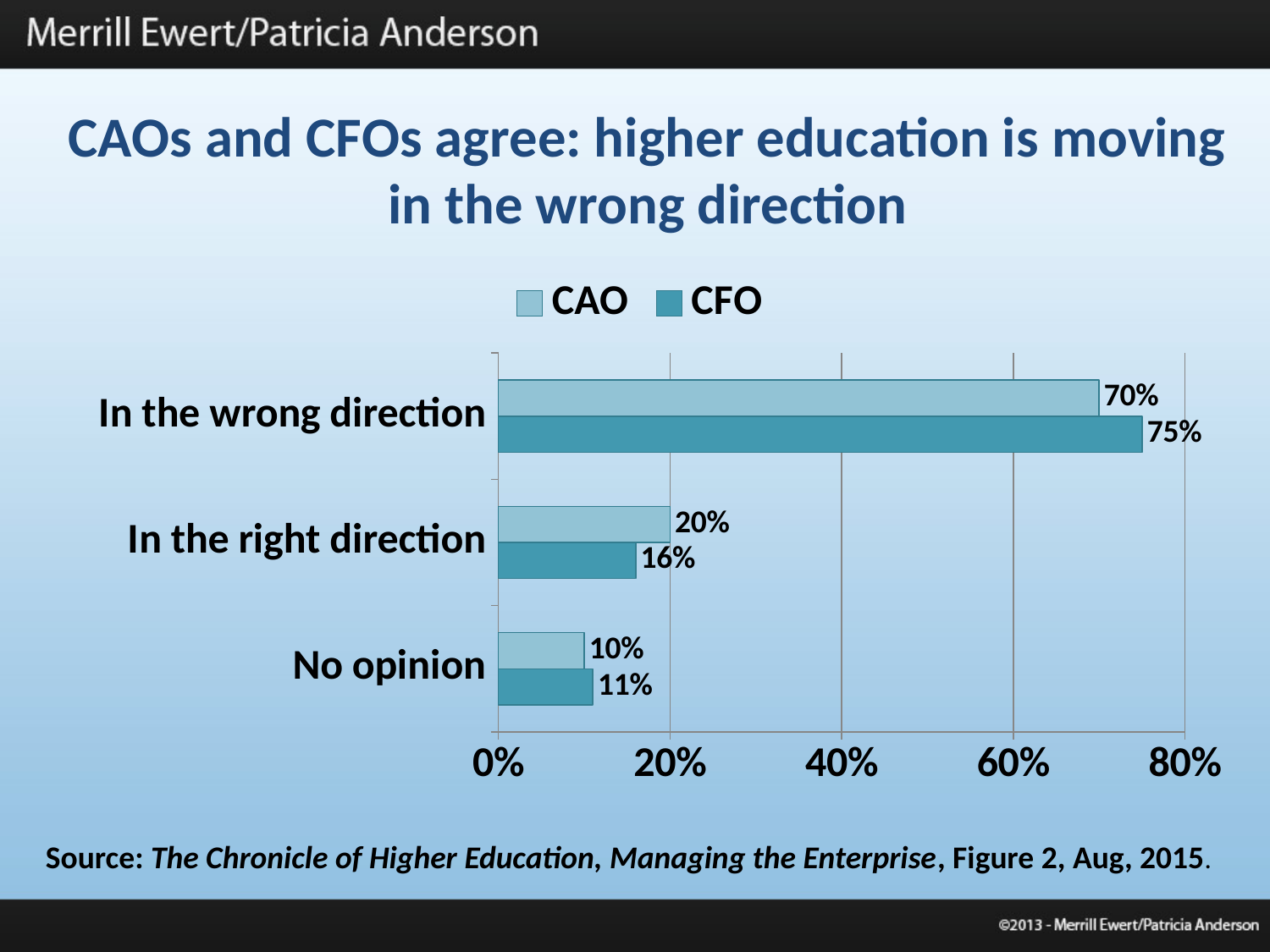
What is the CAO value for 'In the right direction'? 20% Which category has the lowest CAO value? No opinion Which category has the highest CFO value? In the wrong direction What percentage of CAOs say higher education is moving in the wrong direction? 70% Is the CFO value for 'In the wrong direction' greater or less than 60%? greater What percentage of CFOs say higher education is moving in the wrong direction? 75% How many categories are shown on the chart? 3 What is the difference between the CFO and CAO values for 'In the wrong direction'? 5% What is the CFO value for 'No opinion'? 11% How many series does the legend list? 2 What kind of chart is shown on the slide? Bar chart For 'In the right direction', which is larger, the CAO value or the CFO value? CAO